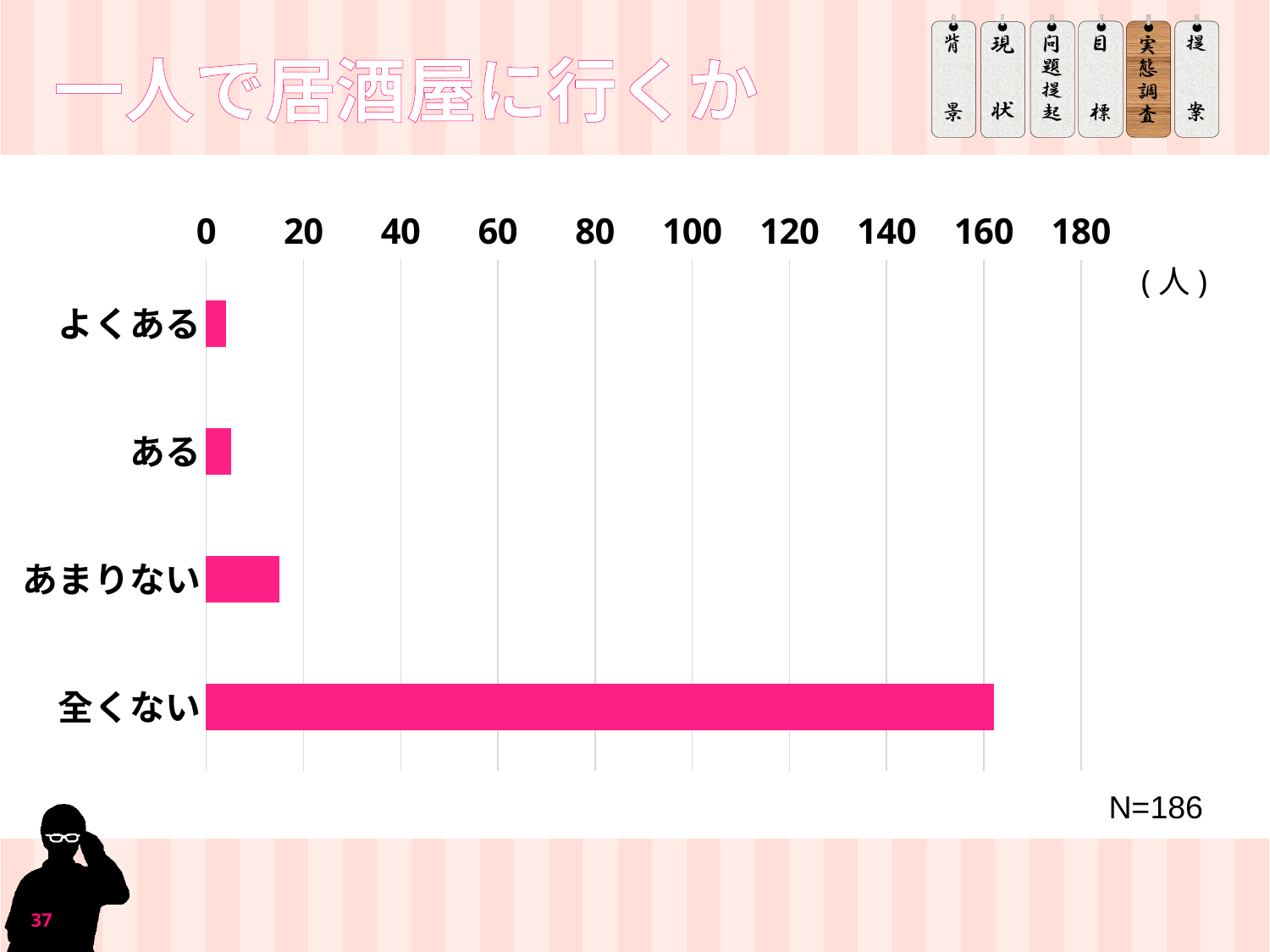
Which is larger, the value for あまりない or the value for ある? あまりない Which is larger, the value for あまりない or the value for 全くない? 全くない What kind of chart is shown on the slide? bar chart Which category has the highest value? 全くない How many categories are plotted in the chart? 4 What is the sample size (N) shown on the slide? N=186 Is the value for よくある greater or less than 20? less What is the title of the chart? 一人で居酒屋に行くか Is the value for あまりない greater or less than 20? less Is the value for 全くない greater or less than 180? less